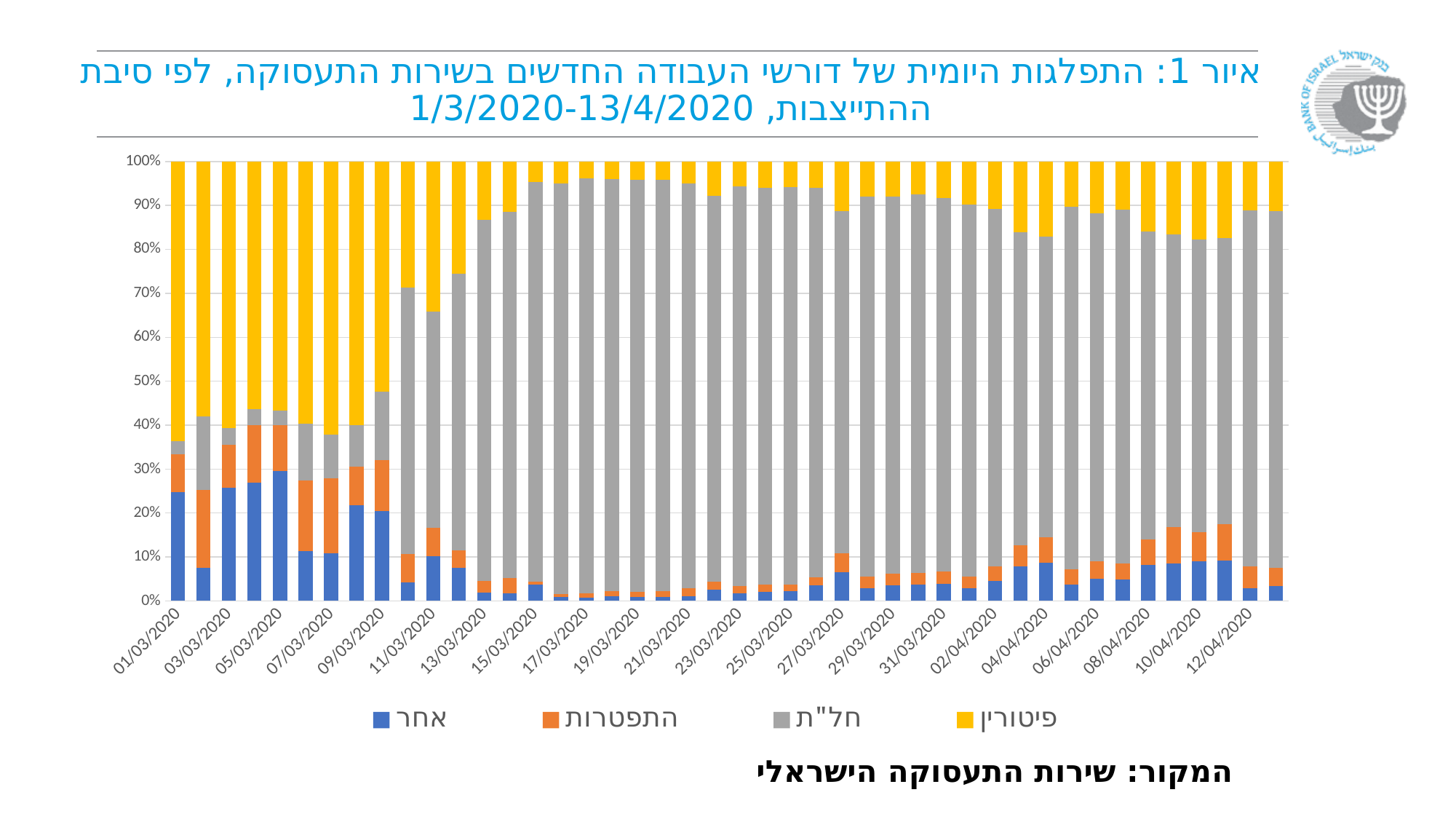
How many series does the legend list? 4 Is the share of אחר on 01/03/2020 greater or less than 20%? greater Which series has the largest share on 12/04/2020? חל"ת Which colour represents חל"ת in the chart? Gray Is the share of פיטורין on 12/04/2020 greater or less than 20%? less On 12/04/2020, which is larger: the share of חל"ת or the share of פיטורין? חל"ת Is the share of חל"ת on 01/03/2020 greater or less than 10%? less On 01/03/2020, which is larger: the share of פיטורין or the share of חל"ת? פיטורין Does the share of חל"ת rise or fall over the period shown on the x axis? rise What kind of chart is shown on the slide? Stacked bar chart Does the share of פיטורין rise or fall over the period shown on the x axis? fall Which series has the largest share on 01/03/2020? פיטורין